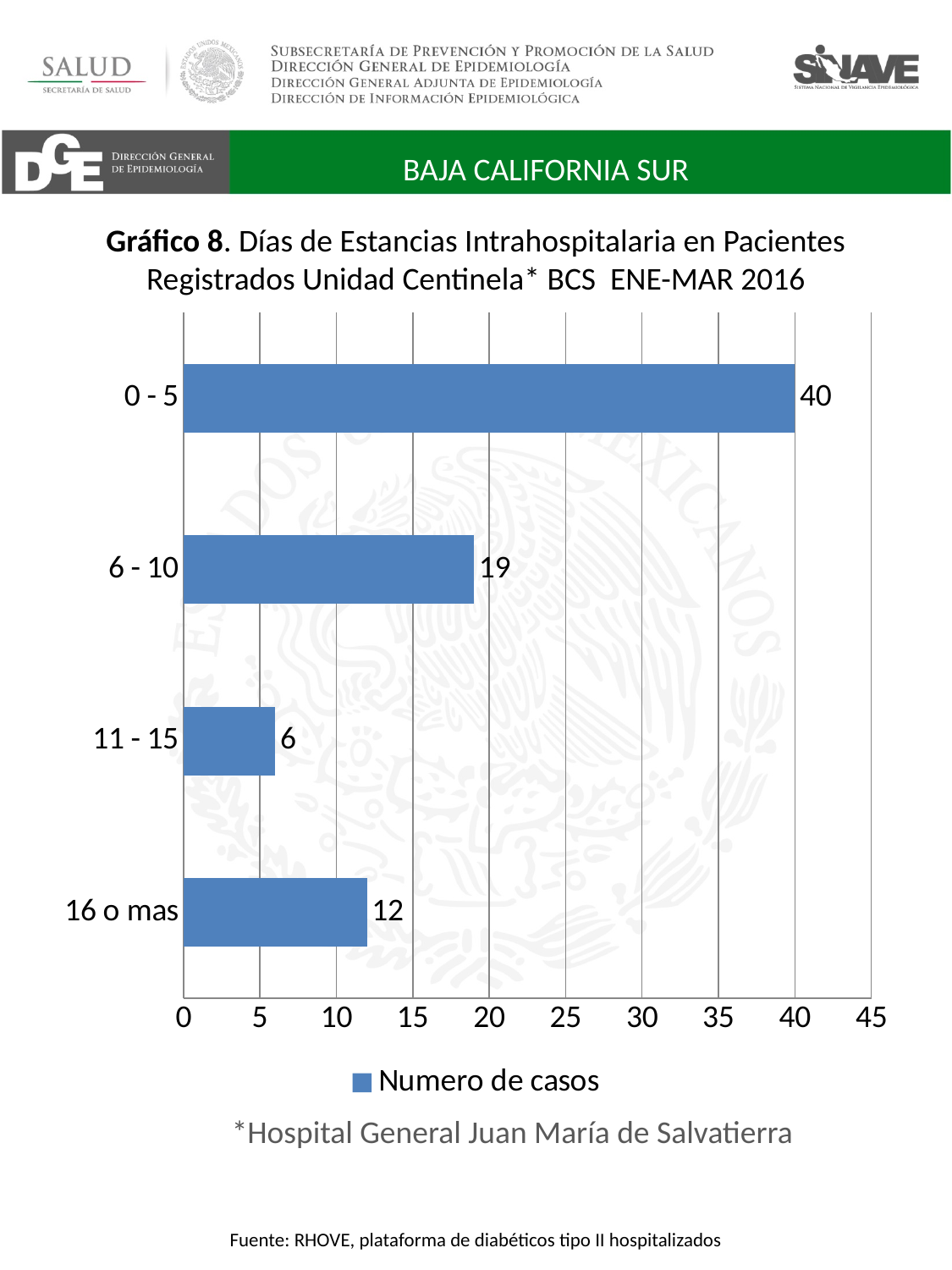
What is the number of cases for the '16 o mas' category? 12 How many categories are shown in the chart? 4 What is the number of cases for the '6 - 10' days category? 19 What series name does the legend show? Numero de casos What kind of chart is shown on the slide? Bar chart What is the number of cases for the '0 - 5' days category? 40 What is the difference in number of cases between the '0 - 5' and '6 - 10' categories? 21 Which category has the lowest number of cases? 11 - 15 Which has more cases, '16 o mas' or '11 - 15'? 16 o mas Is the value for '6 - 10' greater or less than 15? greater What is the number of cases for the '11 - 15' days category? 6 Which category has the highest number of cases? 0 - 5